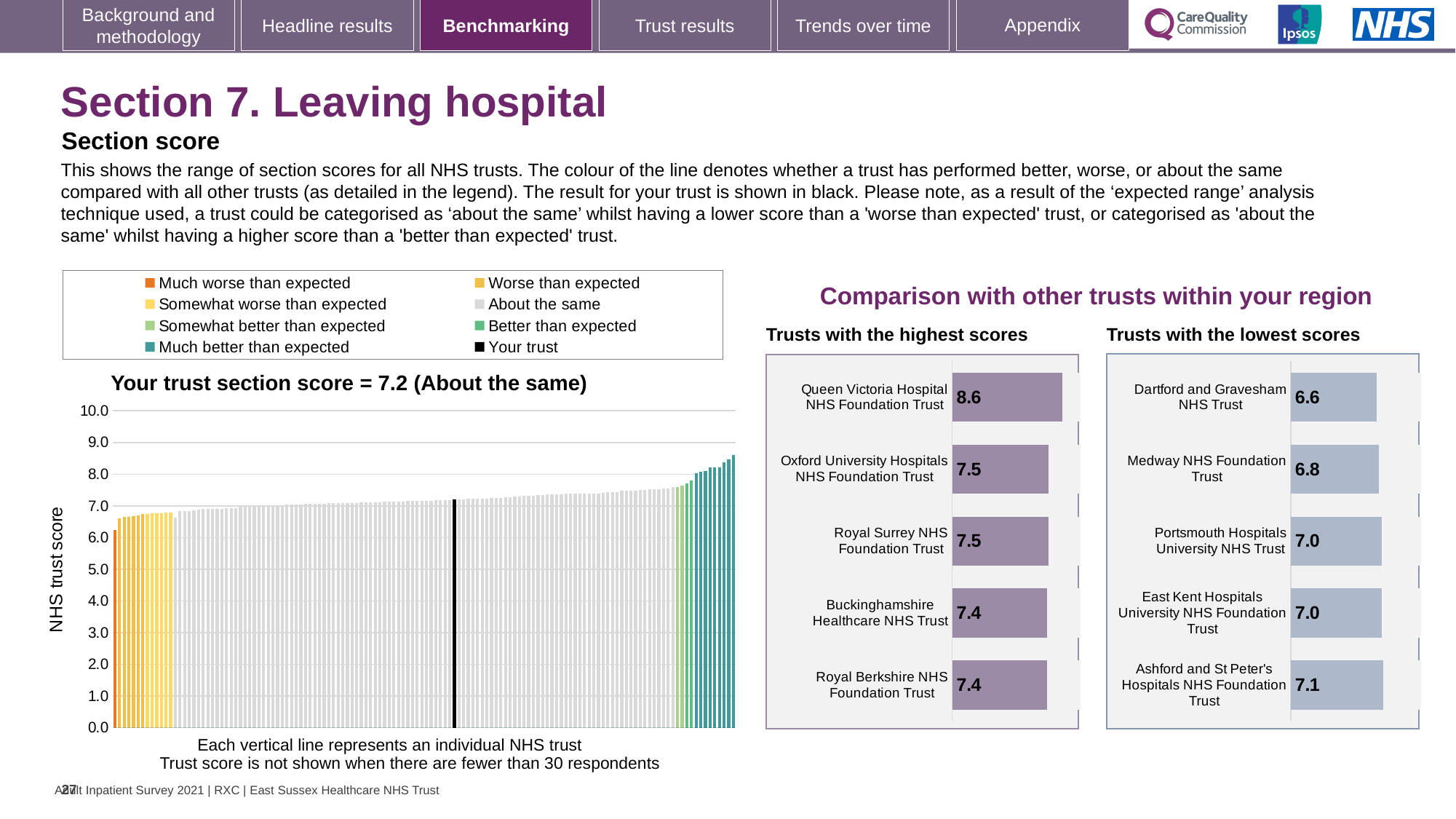
What is the y-axis label of the 'Your trust section score' chart? NHS trust score In the 'Trusts with the highest scores' chart, what is the difference between the scores of Queen Victoria Hospital NHS Foundation Trust and Royal Berkshire NHS Foundation Trust? 1.2 In the 'Your trust section score' chart, do the trust scores rise or fall from left to right? Rise In the 'Trusts with the highest scores' chart, which trust has the highest score? Queen Victoria Hospital NHS Foundation Trust In the 'Your trust section score' chart, what category is your trust placed in? About the same In the 'Trusts with the lowest scores' chart, which has the larger score: Medway NHS Foundation Trust or Dartford and Gravesham NHS Trust? Medway NHS Foundation Trust How many trusts are shown in the 'Trusts with the lowest scores' chart? 5 What kind of chart is the 'Your trust section score' chart? Bar chart In the 'Your trust section score' chart, what is the section score for your trust? 7.2 In the 'Trusts with the lowest scores' chart, which trust has the lowest score? Dartford and Gravesham NHS Trust In the 'Trusts with the highest scores' chart, what is the score for Queen Victoria Hospital NHS Foundation Trust? 8.6 How many entries does the legend above the 'Your trust section score' chart list? 8